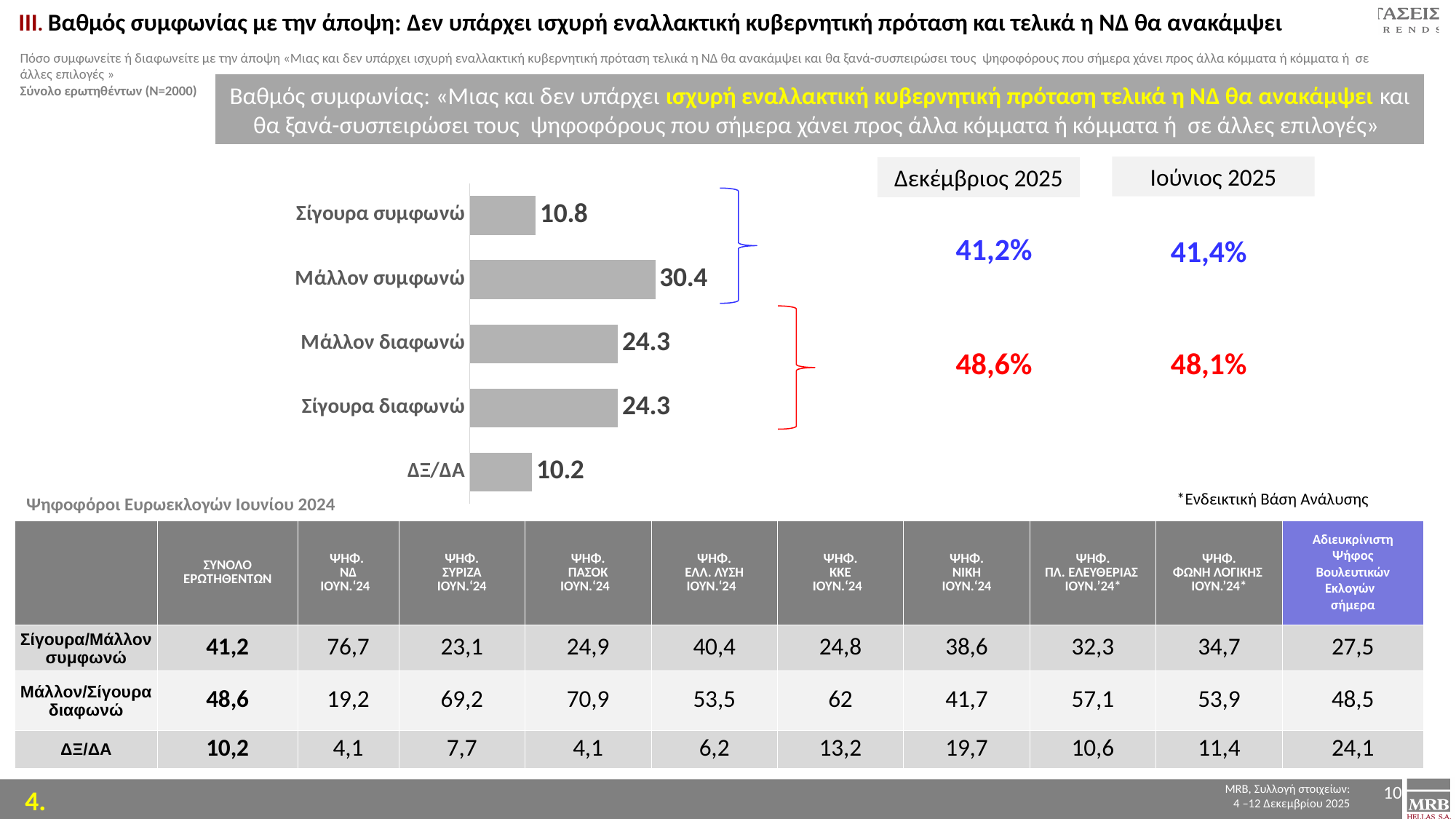
How many categories does the bar chart show? 5 What is the value for Σίγουρα διαφωνώ in the bar chart? 24.3 Which category has the highest value in the bar chart? Μάλλον συμφωνώ What is the difference between the values for Μάλλον συμφωνώ and Σίγουρα συμφωνώ? 19.6 What is the value for ΔΞ/ΔΑ in the bar chart? 10.2 What is the value for Μάλλον συμφωνώ in the bar chart? 30.4 What combined percentage is shown for the disagree categories (red) for Ιούνιος 2025? 48,1% What kind of chart is shown on the slide? bar chart What is the value for Σίγουρα συμφωνώ in the bar chart? 10.8 Which category has the lowest value in the bar chart? ΔΞ/ΔΑ Which is larger in the bar chart: Μάλλον συμφωνώ or Μάλλον διαφωνώ? Μάλλον συμφωνώ What combined percentage is shown for the agree categories (blue) for Δεκέμβριος 2025? 41,2%